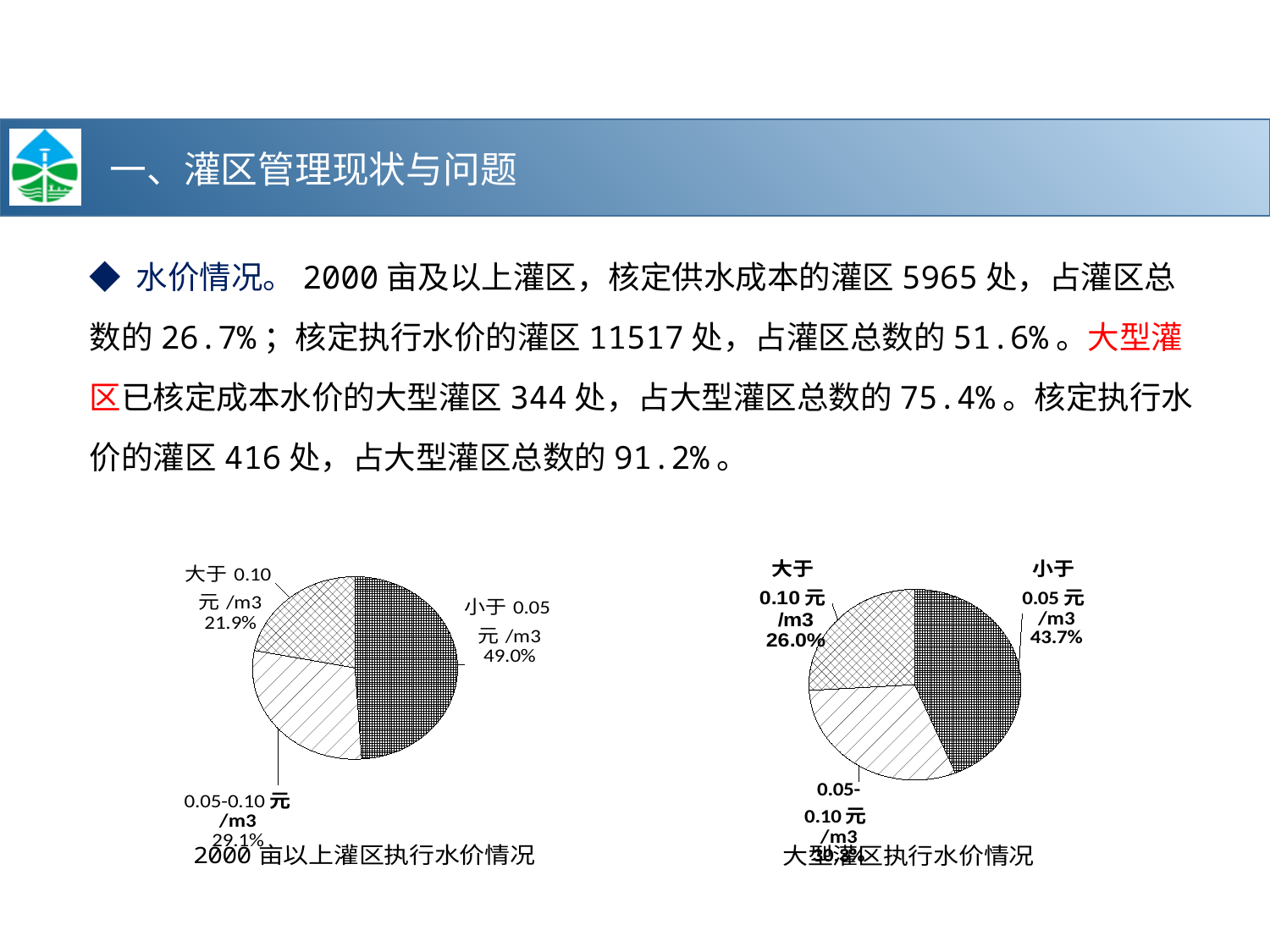
In the right pie chart (大型灌区执行水价情况), what share is labelled for 大于 0.10 元/m3? 26.0% In the left pie chart (2000亩以上灌区执行水价情况), which category has the smallest slice? 大于 0.10 元/m3 What type of chart is used for 大型灌区执行水价情况 on the right? pie chart In the right pie chart (大型灌区执行水价情况), which category has the largest slice? 小于 0.05 元/m3 How many slices does the left pie chart (2000亩以上灌区执行水价情况) have? 3 In the left pie chart (2000亩以上灌区执行水价情况), which category has the largest slice? 小于 0.05 元/m3 In the left pie chart (2000亩以上灌区执行水价情况), what share is labelled for 小于 0.05 元/m3? 49.0% In the left pie chart (2000亩以上灌区执行水价情况), what share is labelled for 大于 0.10 元/m3? 21.9% In the left pie chart (2000亩以上灌区执行水价情况), what is the difference in percentage points between the 小于 0.05 元/m3 slice and the 大于 0.10 元/m3 slice? 27.1 Which is larger: the 大于 0.10 元/m3 share in the left pie chart or the 大于 0.10 元/m3 share in the right pie chart? the right pie chart (26.0%)